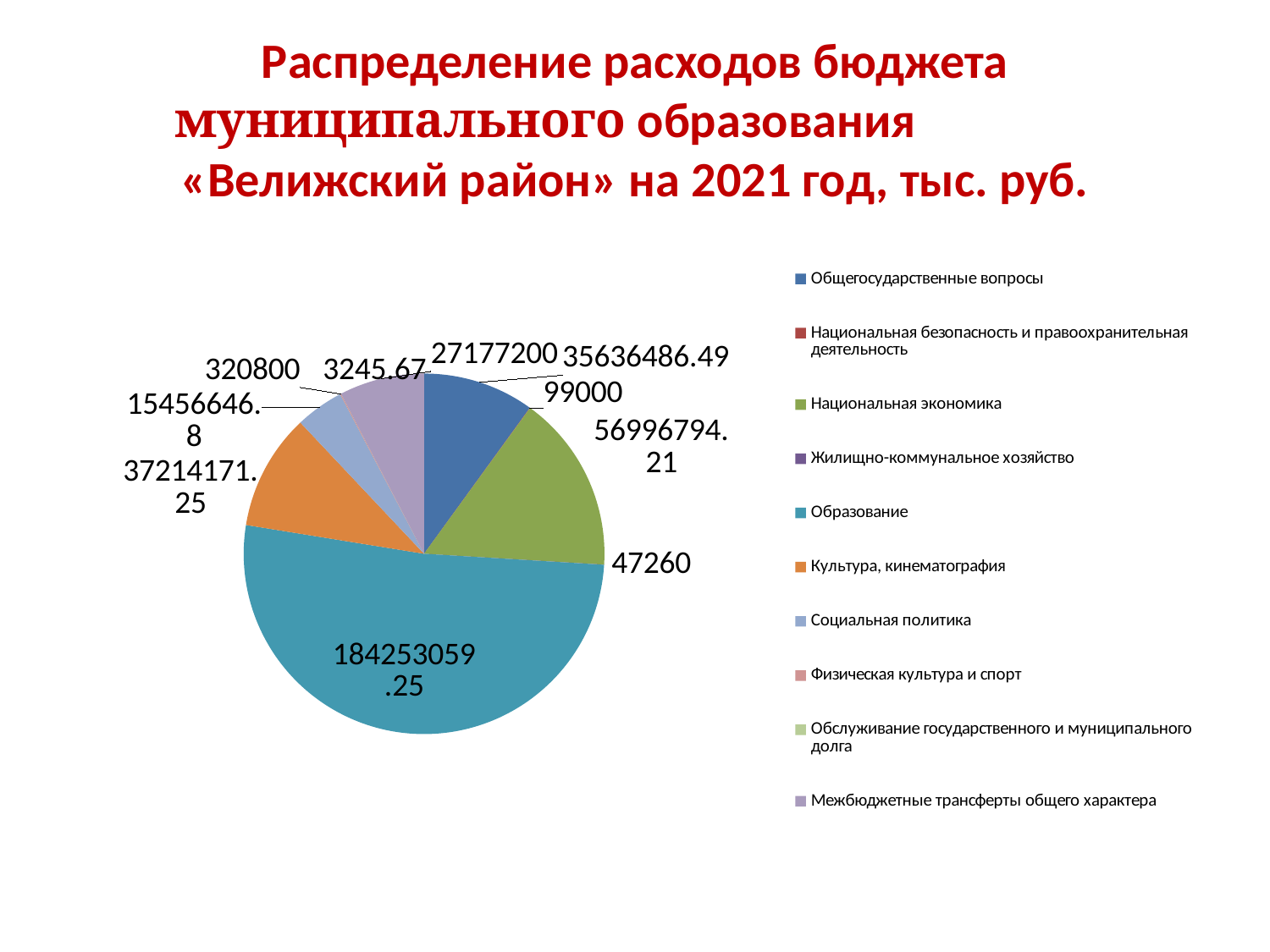
What is the value for Физическая культура и спорт? 320800 How many categories does the legend of the pie chart list? 10 What is the value for Культура, кинематография? 37214171.25 What is the difference between the values for Культура, кинематография and Социальная политика? 21757524.45 What is the difference between the values for Образование and Национальная экономика? 127256265.04 Which is larger, Общегосударственные вопросы or Культура, кинематография? Культура, кинематография Which category has the largest slice of the pie? Образование Which category has the smallest value in the pie chart? Обслуживание государственного и муниципального долга What kind of chart is shown on the slide? pie chart What is the value for Образование? 184253059.25 What is the value for Межбюджетные трансферты общего характера? 27177200 What is the value for Национальная экономика? 56996794.21